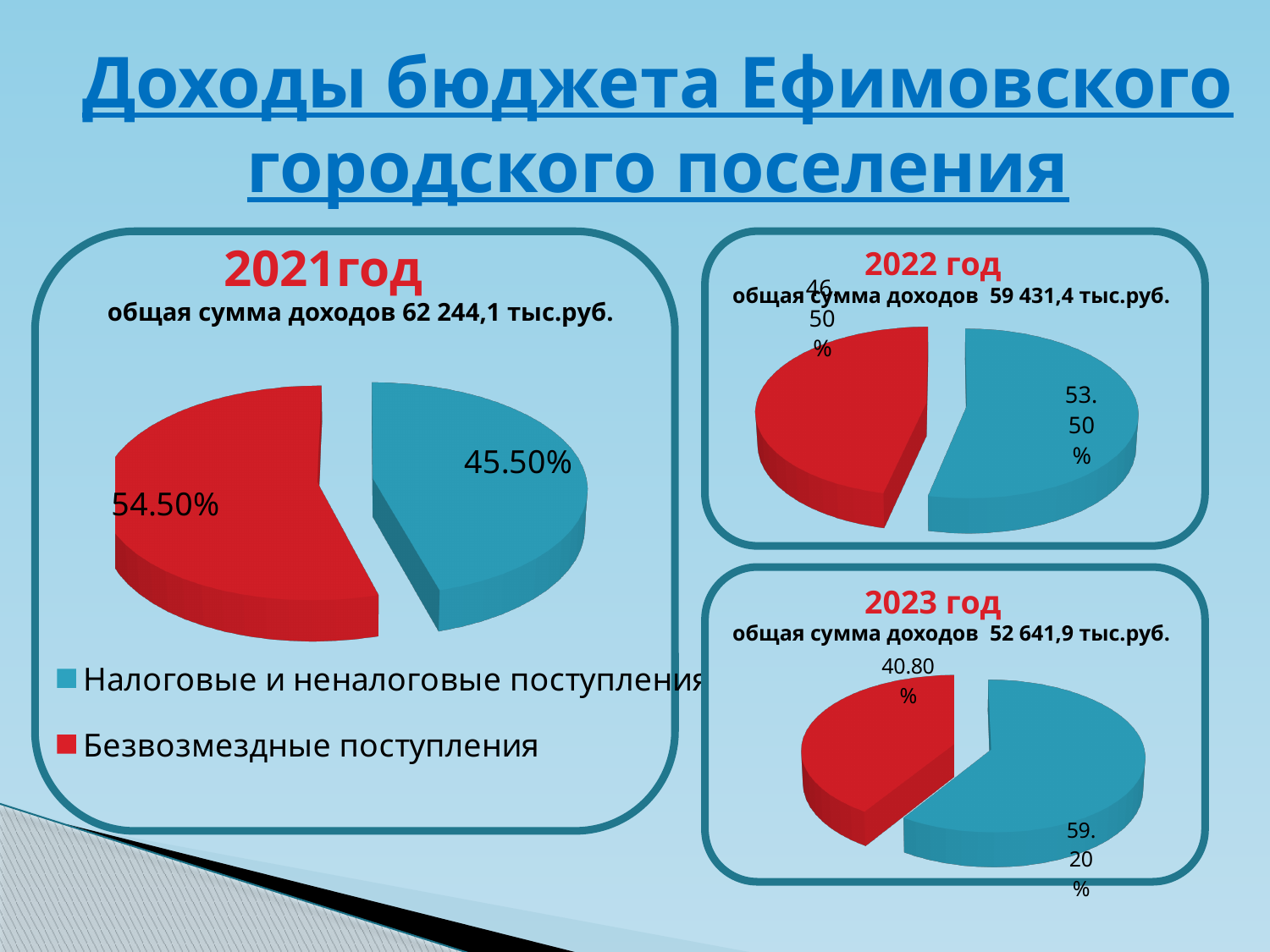
In the 2022 год pie chart, what share is shown for Налоговые и неналоговые поступления? 53.50% What kind of chart is used for the 2021 год data? pie chart In the 2021 год pie chart, which category has the larger slice? Безвозмездные поступления In the 2021 год pie chart, what share is shown for Налоговые и неналоговые поступления? 45.50% In the 2023 год pie chart, what share is shown for Безвозмездные поступления? 40.80% In the 2022 год pie chart, what share is shown for Безвозмездные поступления? 46.50% In the 2023 год pie chart, what share is shown for Налоговые и неналоговые поступления? 59.20% What is the total income (общая сумма доходов) stated for 2022 год? 59 431,4 тыс.руб. In the 2023 год pie chart, which category has the smaller slice? Безвозмездные поступления How many categories does the legend on the slide list? 2 In the 2023 год pie chart, what is the difference between the shares of Налоговые и неналоговые поступления and Безвозмездные поступления? 18.40% In the 2021 год pie chart, what share is shown for Безвозмездные поступления? 54.50%